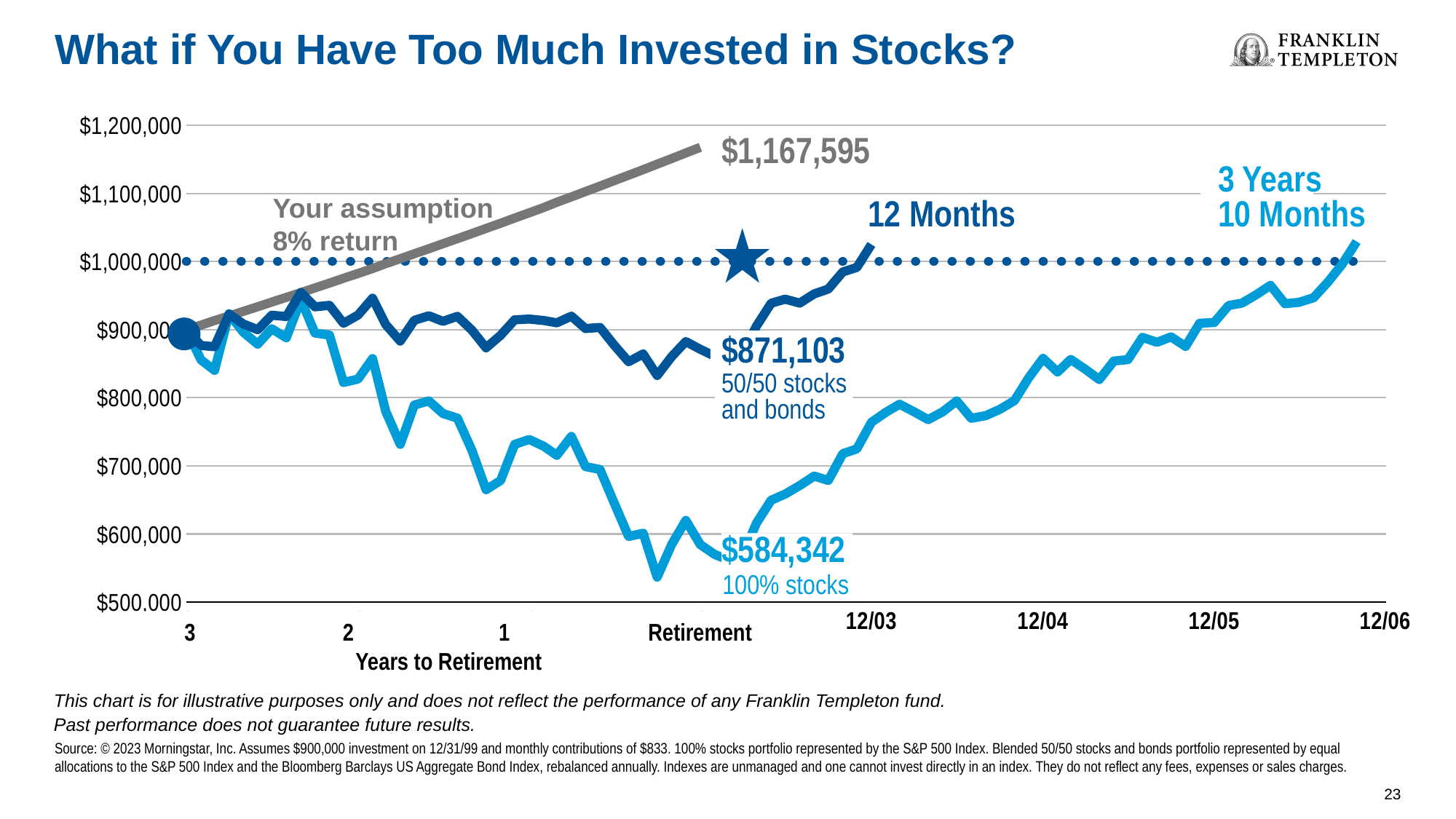
What is the difference between the 50/50 stocks and bonds value and the 100% stocks value at retirement? $286,761 What kind of chart is shown on the slide? Line chart What is the value of the 50/50 stocks and bonds portfolio at retirement? $871,103 How long does the chart say it took the 50/50 stocks and bonds portfolio to recover to $1,000,000 after retirement? 12 Months Which of the three lines has the lowest value at retirement? 100% stocks What is the label on the x axis of the chart? Years to Retirement At retirement, which portfolio has the larger value: 50/50 stocks and bonds or 100% stocks? 50/50 stocks and bonds How much higher is the 8% return assumption value at retirement than the 50/50 stocks and bonds value? $296,492 How long does the chart say it took the 100% stocks portfolio to recover to $1,000,000 after retirement? 3 Years 10 Months What is the value of the 100% stocks portfolio at retirement? $584,342 What is the value shown for the 'Your assumption 8% return' line at retirement? $1,167,595 Which of the three lines has the highest value at retirement? Your assumption 8% return